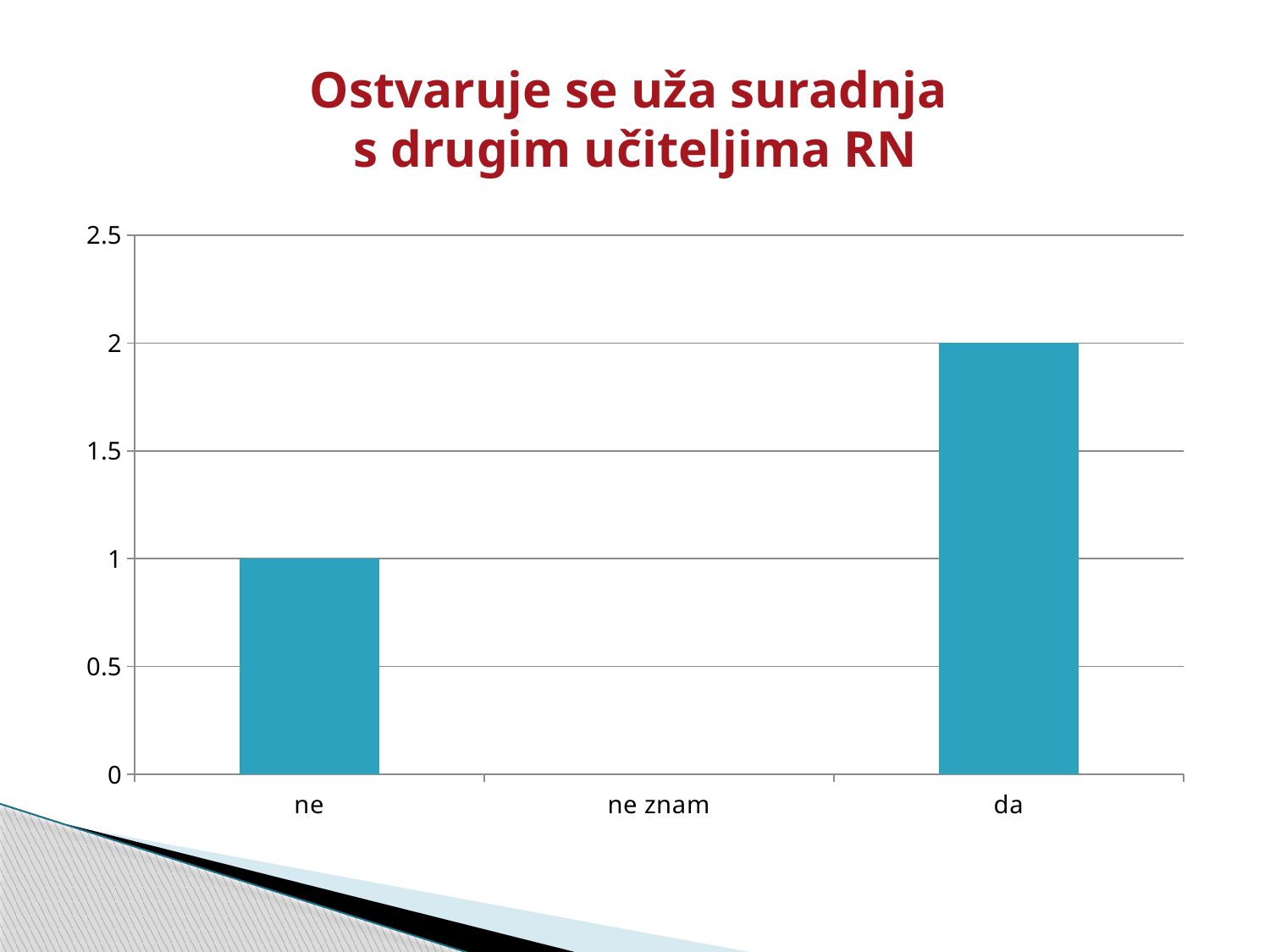
What type of chart is shown on the slide? bar chart What is the title of the chart? Ostvaruje se uža suradnja s drugim učiteljima RN Is the value for "ne" greater or less than 1.5? less Is the value for "da" greater or less than 1.5? greater What is the value for "ne znam"? 0 How many categories are shown on the x axis? 3 What is the difference between the values for "da" and "ne"? 1 What is the value for "da"? 2 Which is larger, the value for "ne" or the value for "da"? da What is the value for "ne"? 1 Which category has the highest value? da Which category has the lowest value? ne znam